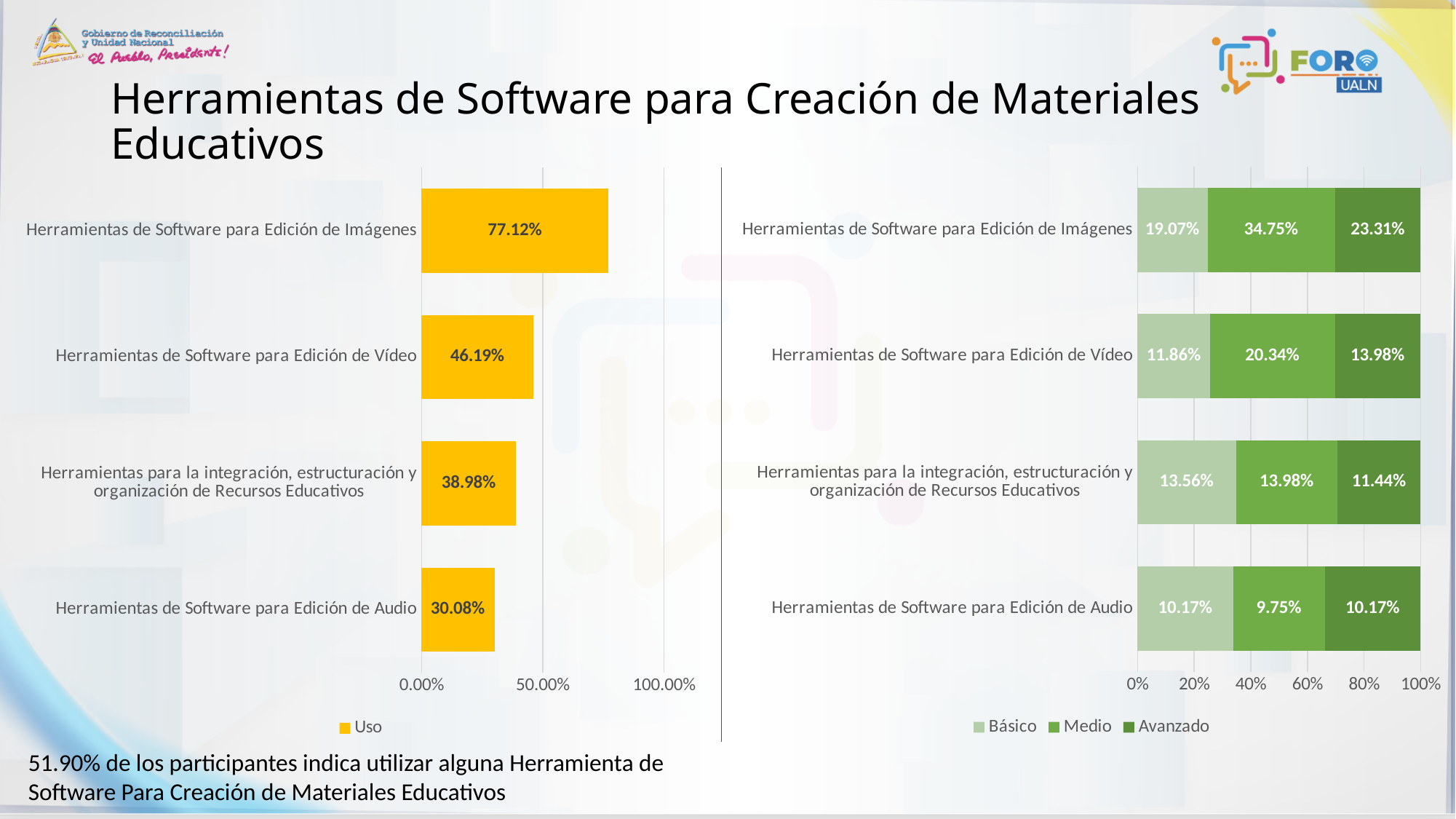
In the right chart, what is the total of the stacked bar for Herramientas para la integración, estructuración y organización de Recursos Educativos? 38.98% What kind of chart is the chart on the right side of the slide? Stacked bar chart In the left chart (Uso), what is the difference between the values for Edición de Imágenes and Edición de Audio? 47.04% In the left chart (Uso), which category has the lowest value? Herramientas de Software para Edición de Audio In the right chart, what is the Medio value for Herramientas de Software para Edición de Imágenes? 34.75% In the right chart, how many series does the legend list? 3 In the left chart (Uso), how many categories are shown? 4 In the left chart (Uso), what is the value for Herramientas de Software para Edición de Audio? 30.08% In the left chart (Uso), what is the value for Herramientas de Software para Edición de Imágenes? 77.12% In the left chart (Uso), which category has the highest value? Herramientas de Software para Edición de Imágenes In the right chart, which is larger for Herramientas de Software para Edición de Audio: the Básico value or the Medio value? Básico In the right chart, what is the Avanzado value for Herramientas de Software para Edición de Vídeo? 13.98%